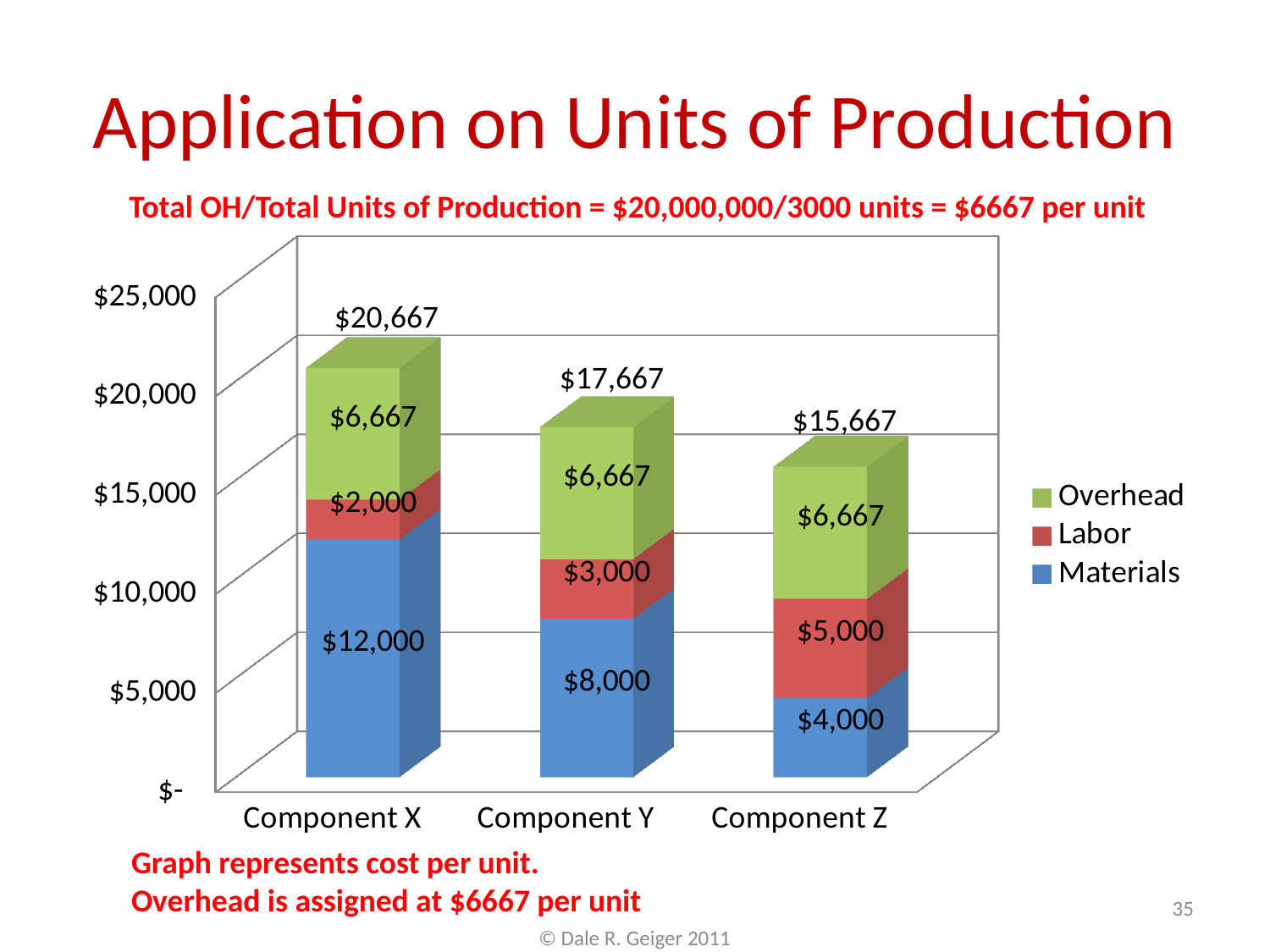
Which component has the lowest Materials value? Component Z What is the difference between the Materials values for Component X and Component Y? $4,000 Which series is shown in green in the legend? Overhead What kind of chart is shown on the slide? Stacked bar chart What is the Materials value for Component X? $12,000 What is the total cost per unit shown for Component Y? $17,667 How many series does the legend list? 3 How many components are shown on the x axis? 3 What is the Overhead value for Component Y? $6,667 Which component has the highest total cost per unit? Component X What is the Labor value for Component Z? $5,000 Which is larger, the Labor value for Component Y or the Labor value for Component Z? Component Z